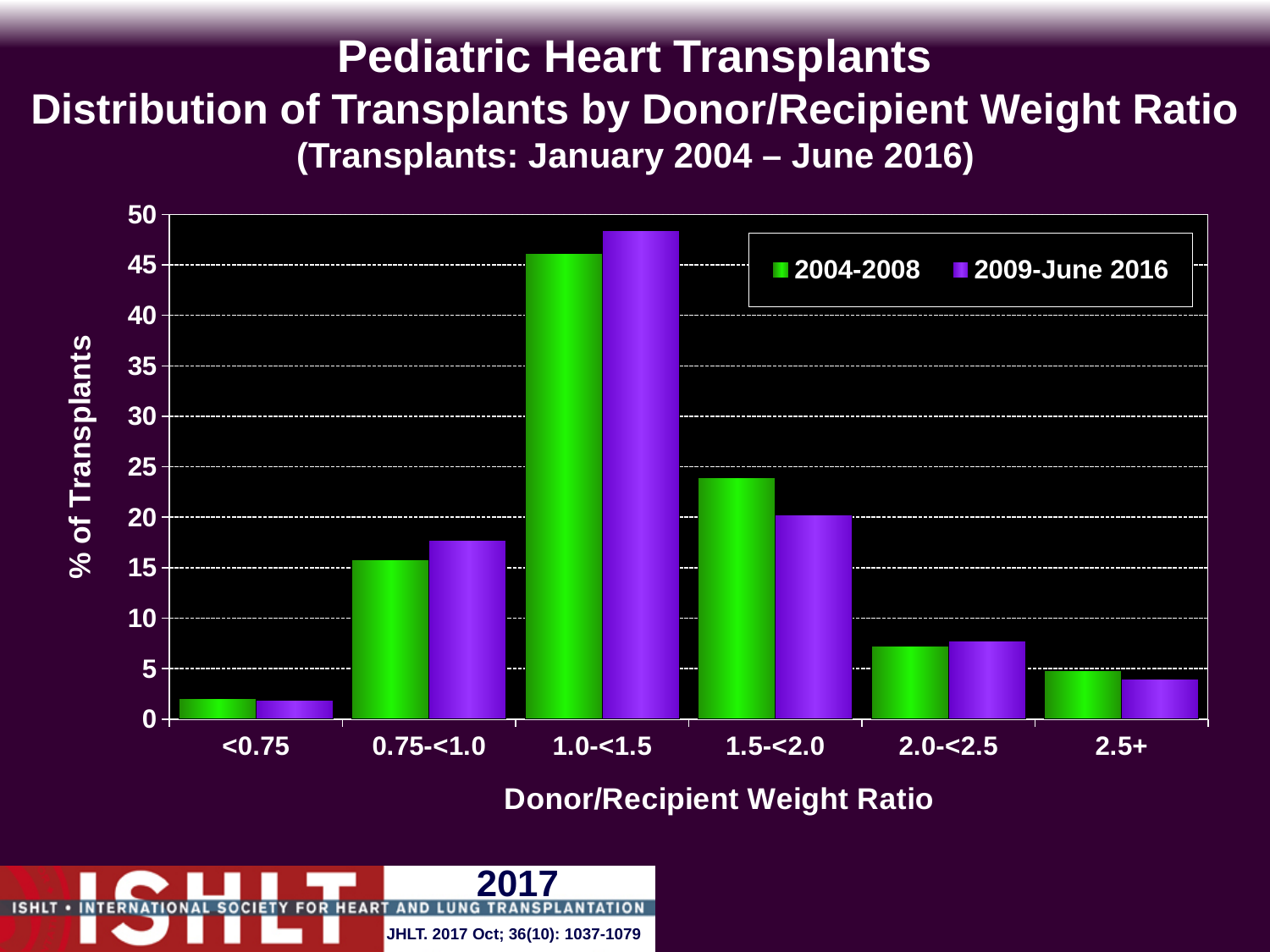
Is the value for 0.75-<1.0 in the 2004-2008 series greater or less than 20? less Is the value for 1.0-<1.5 in the 2004-2008 series greater or less than 40? greater How many donor/recipient weight ratio categories are shown on the x axis? 6 For the 2009-June 2016 series, which weight ratio category has the highest percentage of transplants? 1.0-<1.5 What is the label of the y axis? % of Transplants In the 1.5-<2.0 category, which series has the larger value, 2004-2008 or 2009-June 2016? 2004-2008 In the 0.75-<1.0 category, which series has the larger value, 2004-2008 or 2009-June 2016? 2009-June 2016 For the 2004-2008 series, which weight ratio category has the lowest percentage of transplants? <0.75 How many series does the legend list? 2 For the 2004-2008 series, which weight ratio category has the highest percentage of transplants? 1.0-<1.5 What kind of chart is shown on the slide? bar chart Is the value for 1.5-<2.0 in the 2009-June 2016 series greater or less than 25? less